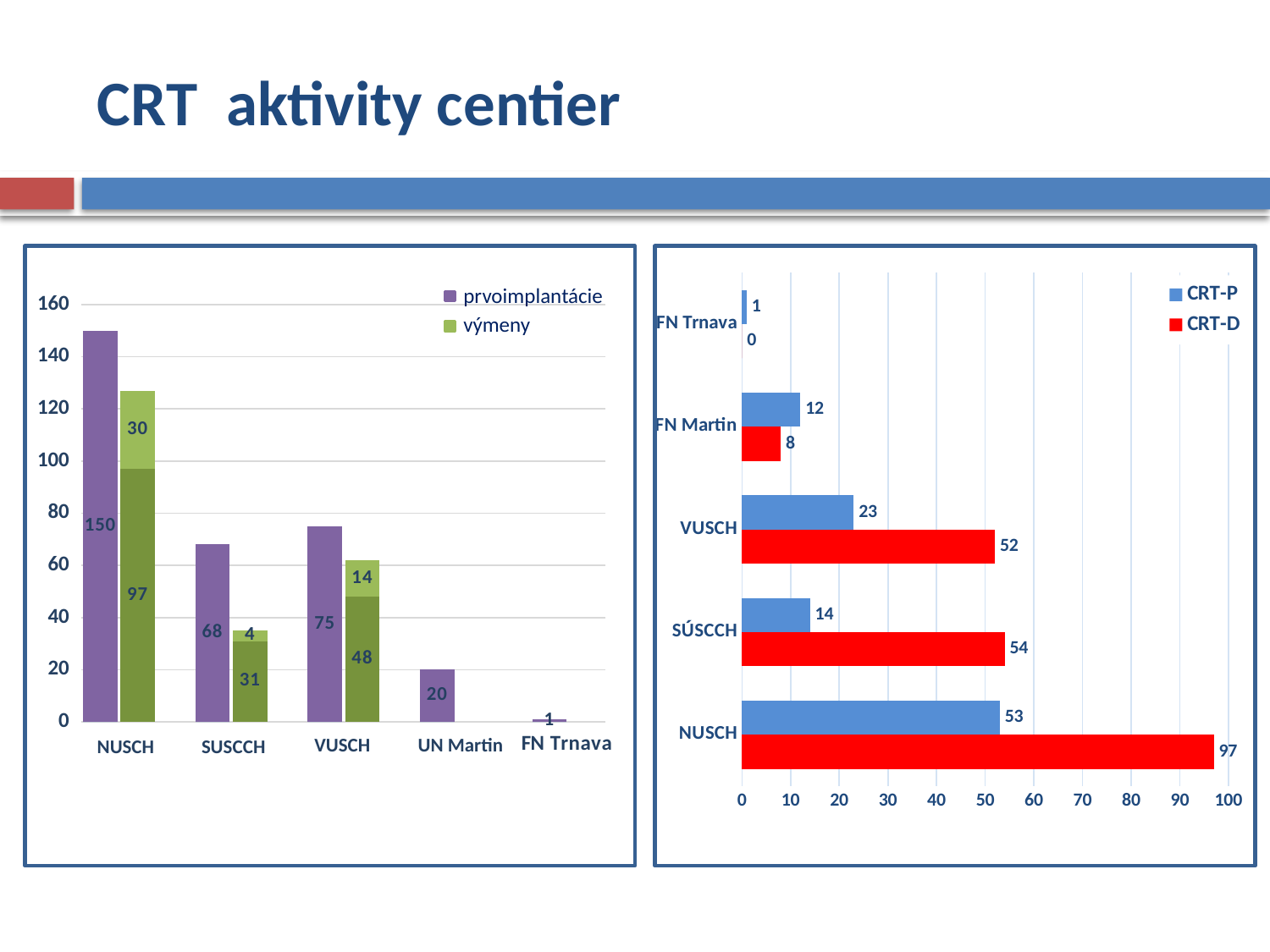
On the left chart, what is the prvoimplantácie value for UN Martin? 20 On the left chart, what is the prvoimplantácie value for SUSCCH? 68 What kind of chart is the right chart? Bar chart On the right chart, what is the difference between the CRT-D and CRT-P values for SÚSCCH? 40 On the right chart, what is the CRT-P value for VUSCH? 23 On the right chart, how many series does the legend list? 2 On the right chart, what colour are the CRT-D bars? Red On the right chart, which centre has the highest CRT-D value? NUSCH On the left chart, how many centres are shown on the x axis? 5 On the right chart, what is the CRT-D value for NUSCH? 97 On the left chart, which centre has the lowest prvoimplantácie value? FN Trnava On the right chart, which is larger for FN Martin: CRT-P or CRT-D? CRT-P